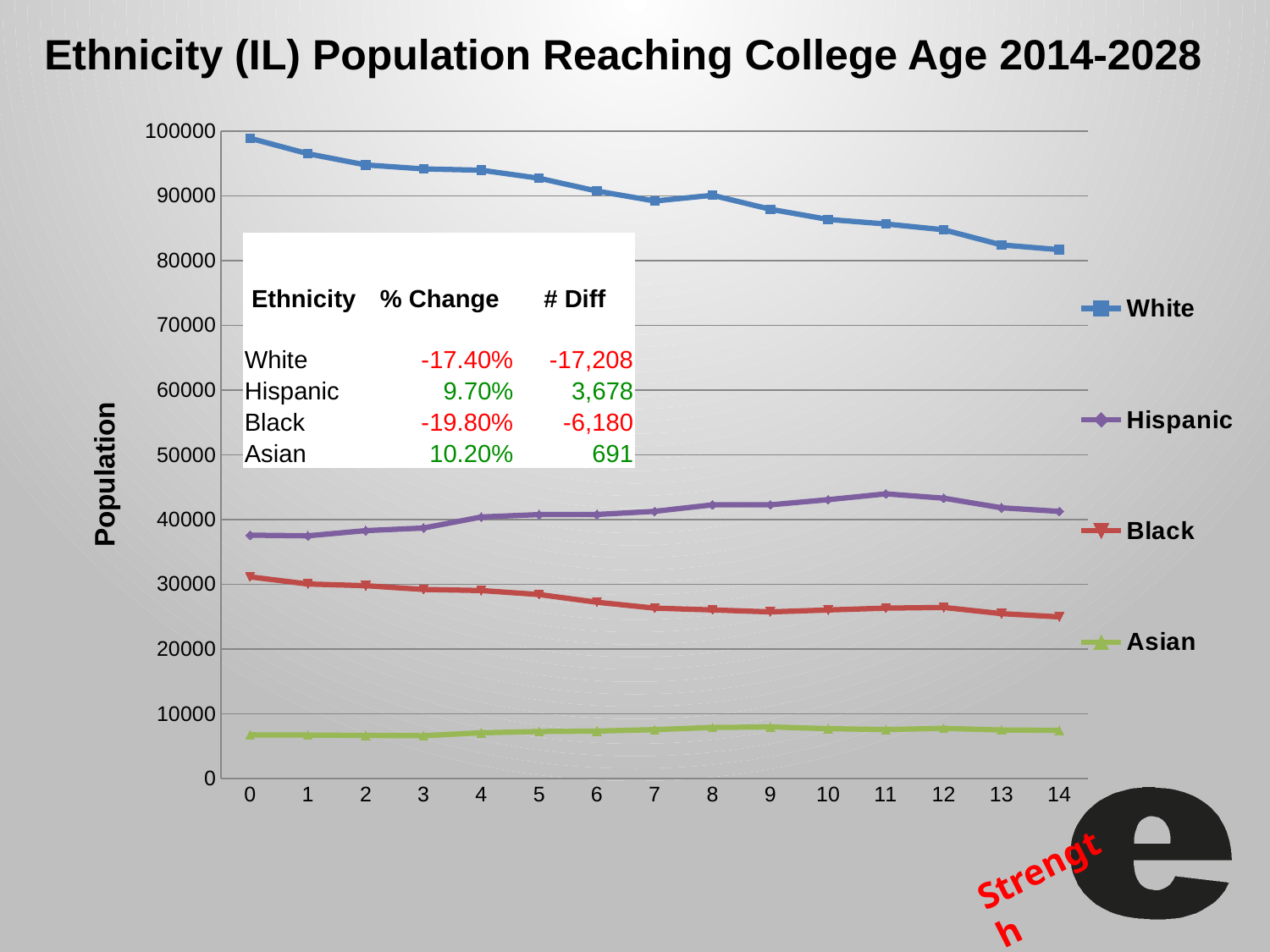
What kind of chart is shown on the slide? line chart Which series has the highest population values across the chart? White Do the values for the Black series rise or fall along the x axis? fall At x = 14, which is larger, the Hispanic value or the Black value? Hispanic According to the table on the chart, what is the % Change for Black? -19.80% Is the value for White at x = 0 greater or less than 90000? greater Is the value for Asian at x = 0 greater or less than 10000? less Do the values for the White series rise or fall along the x axis? fall How many series does the legend list? 4 Which series has the lowest population values across the chart? Asian How many points are plotted along the x axis for each series? 15 Is the value for Black at x = 14 greater or less than 30000? less